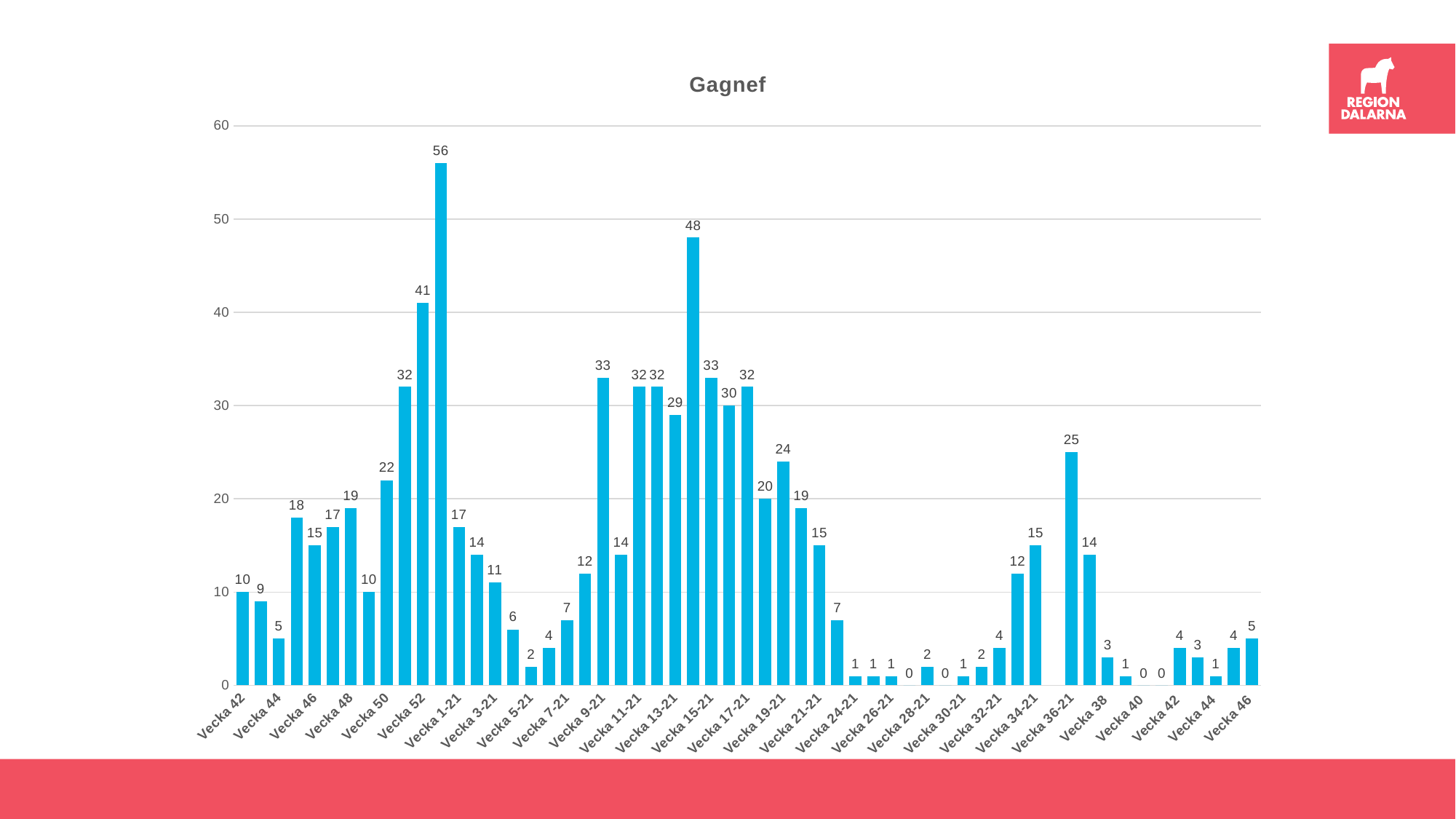
What is the value for Vecka 9-21? 33 What is the title of the chart? Gagnef What is the highest value shown in the chart? 56 What is the value for Vecka 36-21? 25 What is the value for Vecka 52? 41 Do the values generally rise or fall from Vecka 17-21 to Vecka 24-21? fall What is the value for Vecka 50? 22 Which has a larger value, Vecka 9-21 or Vecka 13-21? Vecka 9-21 What is the difference between the values for Vecka 52 and Vecka 50? 19 What is the lowest value shown in the chart? 0 What kind of chart is shown on the slide? bar chart